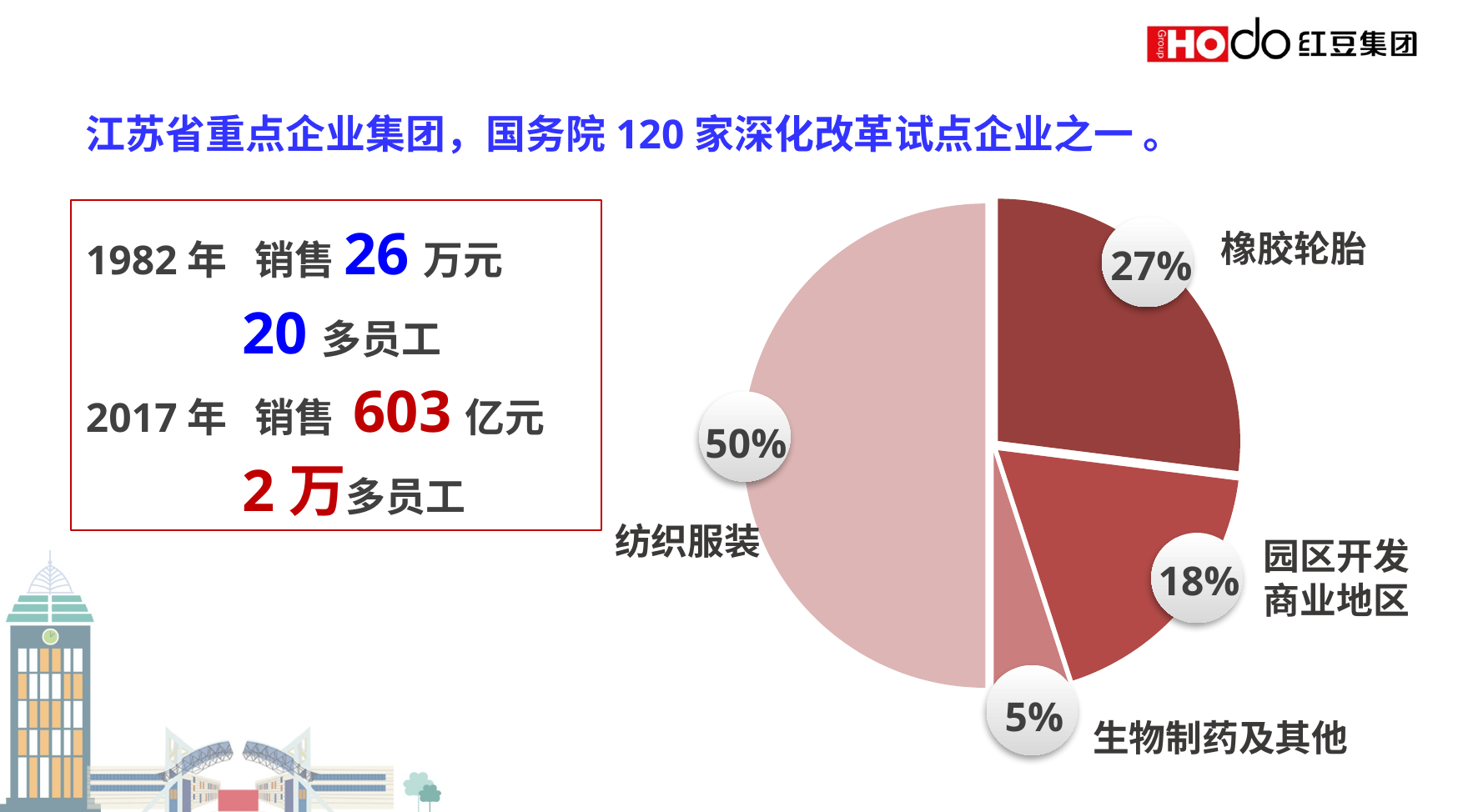
Which is larger, the 橡胶轮胎 slice or the 园区开发商业地区 slice? 橡胶轮胎 Which slice of the pie chart is the smallest? 生物制药及其他 What is the difference in percentage points between the 橡胶轮胎 slice and the 园区开发商业地区 slice? 9 What is the difference in percentage points between the 纺织服装 slice and the 生物制药及其他 slice? 45 What share of the pie does 生物制药及其他 account for? 5% Which slice of the pie chart is the largest? 纺织服装 What share of the pie does 橡胶轮胎 account for? 27% What share of the pie does 纺织服装 account for? 50% What kind of chart is shown on the slide? pie chart How many slices does the pie chart have? 4 Which slice of the pie chart is drawn in the lightest pink colour? 纺织服装